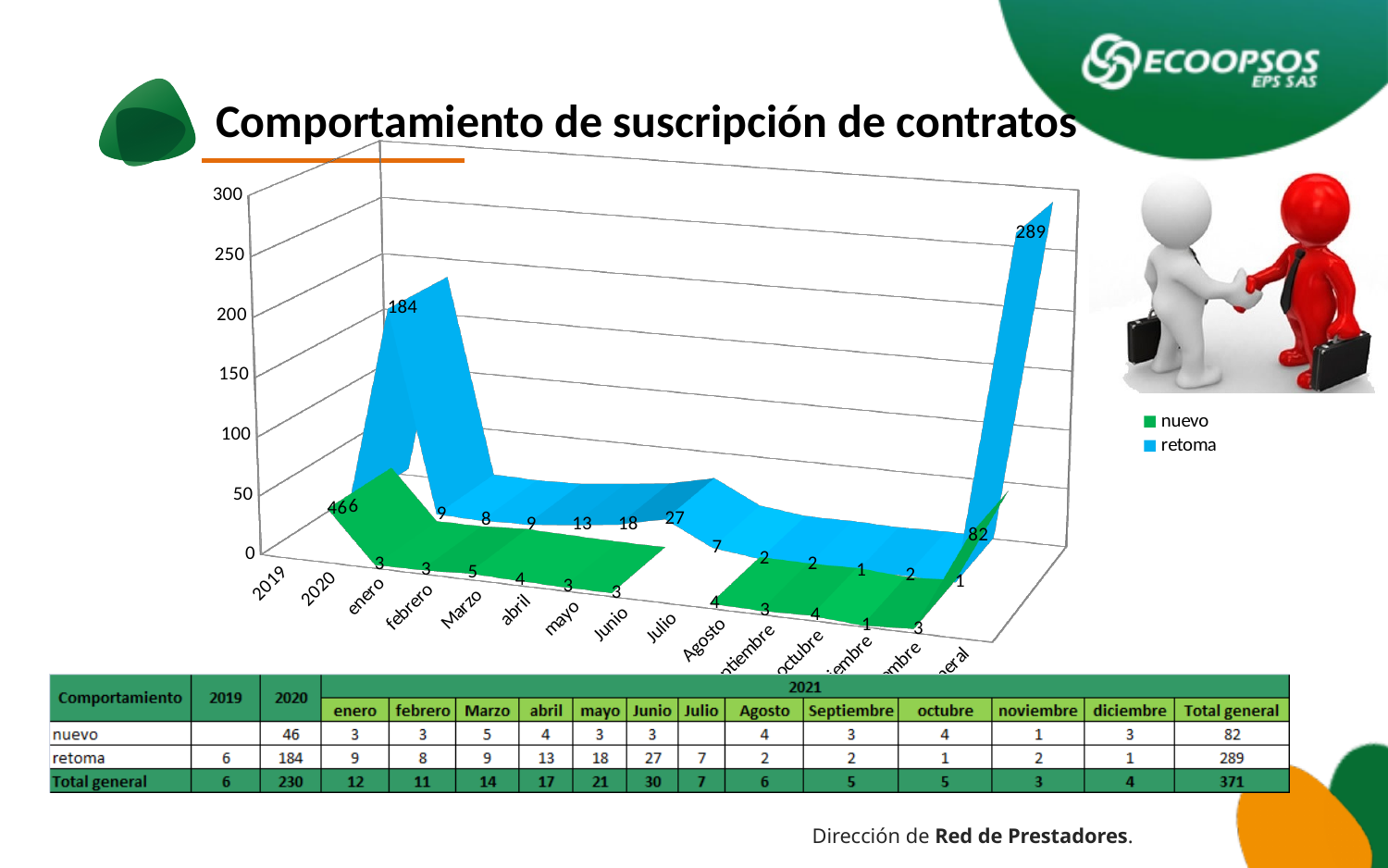
What is the value of nuevo for Marzo in the chart? 5 What is the difference between the retoma and nuevo values for 2020? 138 What is the Total general value for retoma shown in the chart? 289 What are the two series named in the chart legend? nuevo and retoma What kind of chart is shown on the slide? 3D line chart How many series does the chart legend list? 2 What is the value of retoma for 2020 in the chart? 184 Is the retoma value for 2020 greater or less than 150? greater What is the value of retoma for Junio in the chart? 27 What is the value of nuevo for 2020 in the chart? 46 Among the 2021 months, which month has the highest retoma value? Junio Which series has the higher Total general value, nuevo or retoma? retoma